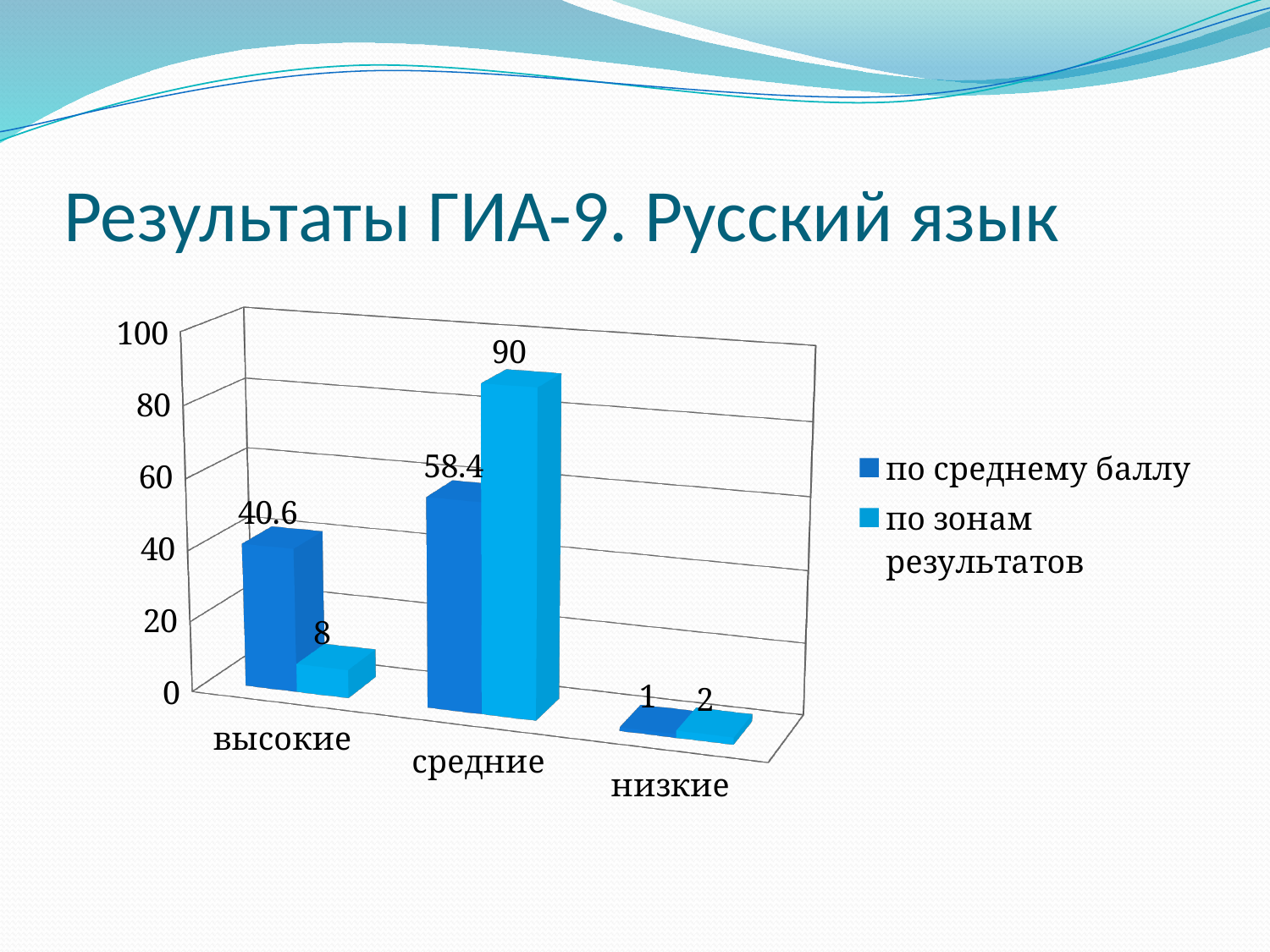
How many categories are shown on the x axis? 3 How many series does the legend list? 2 Which category has the lowest value in the "по зонам результатов" series? низкие What is the difference between the "по зонам результатов" and "по среднему баллу" values for "средние"? 31.6 What is the title of the slide? Результаты ГИА-9. Русский язык What is the value for "средние" in the "по зонам результатов" series? 90 Which category has the highest value in the "по среднему баллу" series? средние What is the value for "низкие" in the "по среднему баллу" series? 1 What is the value for "высокие" in the "по зонам результатов" series? 8 What kind of chart is shown on the slide? bar chart What is the value for "высокие" in the "по среднему баллу" series? 40.6 For "высокие", which series has the larger value: "по среднему баллу" or "по зонам результатов"? по среднему баллу